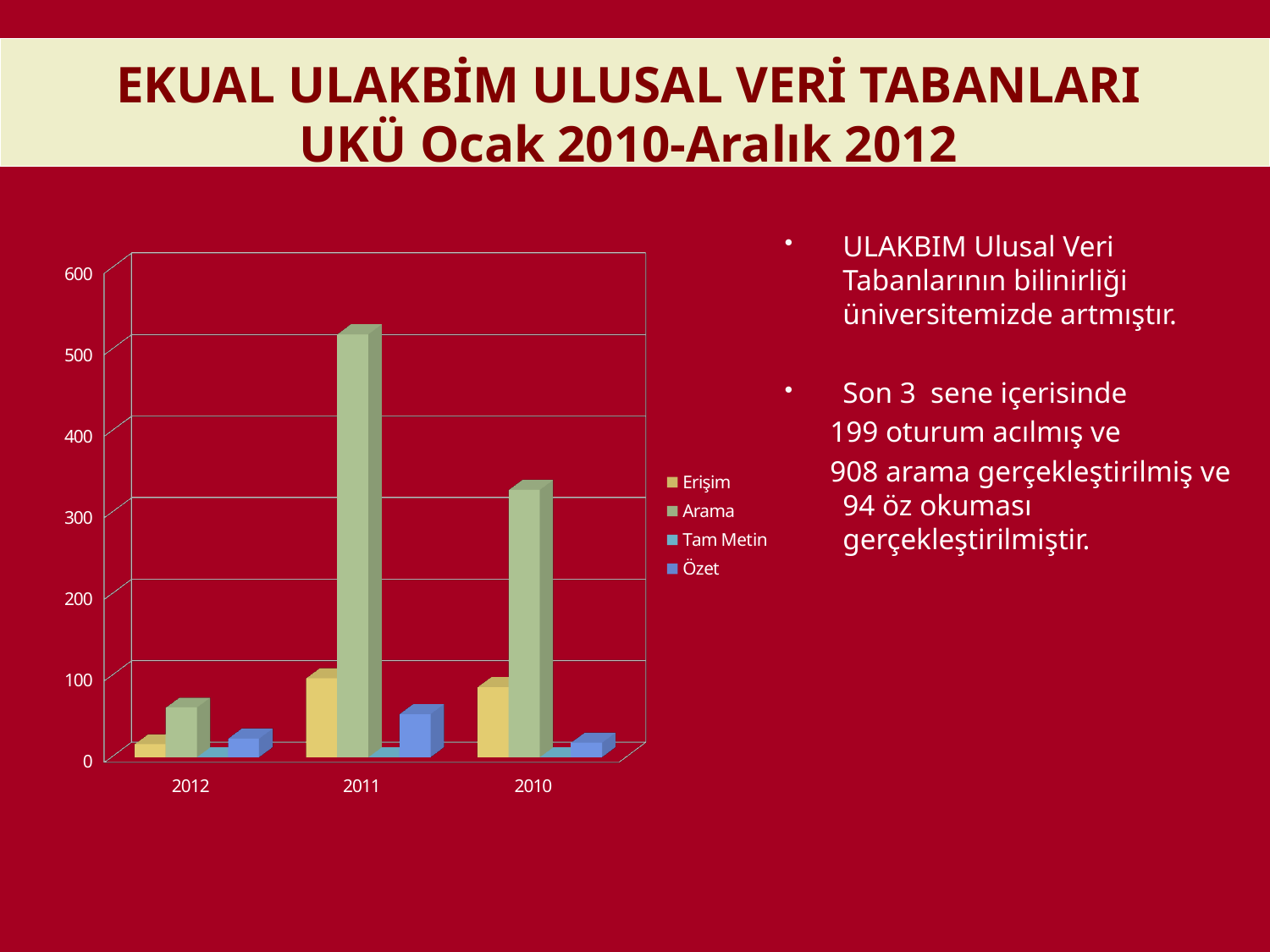
Which series is shown in green in the chart's legend? Arama Is the value for Arama in 2010 greater or less than 300? greater Is the value for Özet in 2011 greater or less than 100? less Which year has the lowest value for Arama? 2012 Which is larger, the Arama value for 2011 or for 2010? 2011 Which is larger, the Erişim value for 2011 or for 2012? 2011 How many categories are shown on the x axis of the chart? 3 Which year has the highest value for Arama? 2011 How many series does the chart's legend list? 4 What kind of chart is shown on the slide? bar chart Is the value for Arama in 2012 greater or less than 100? less